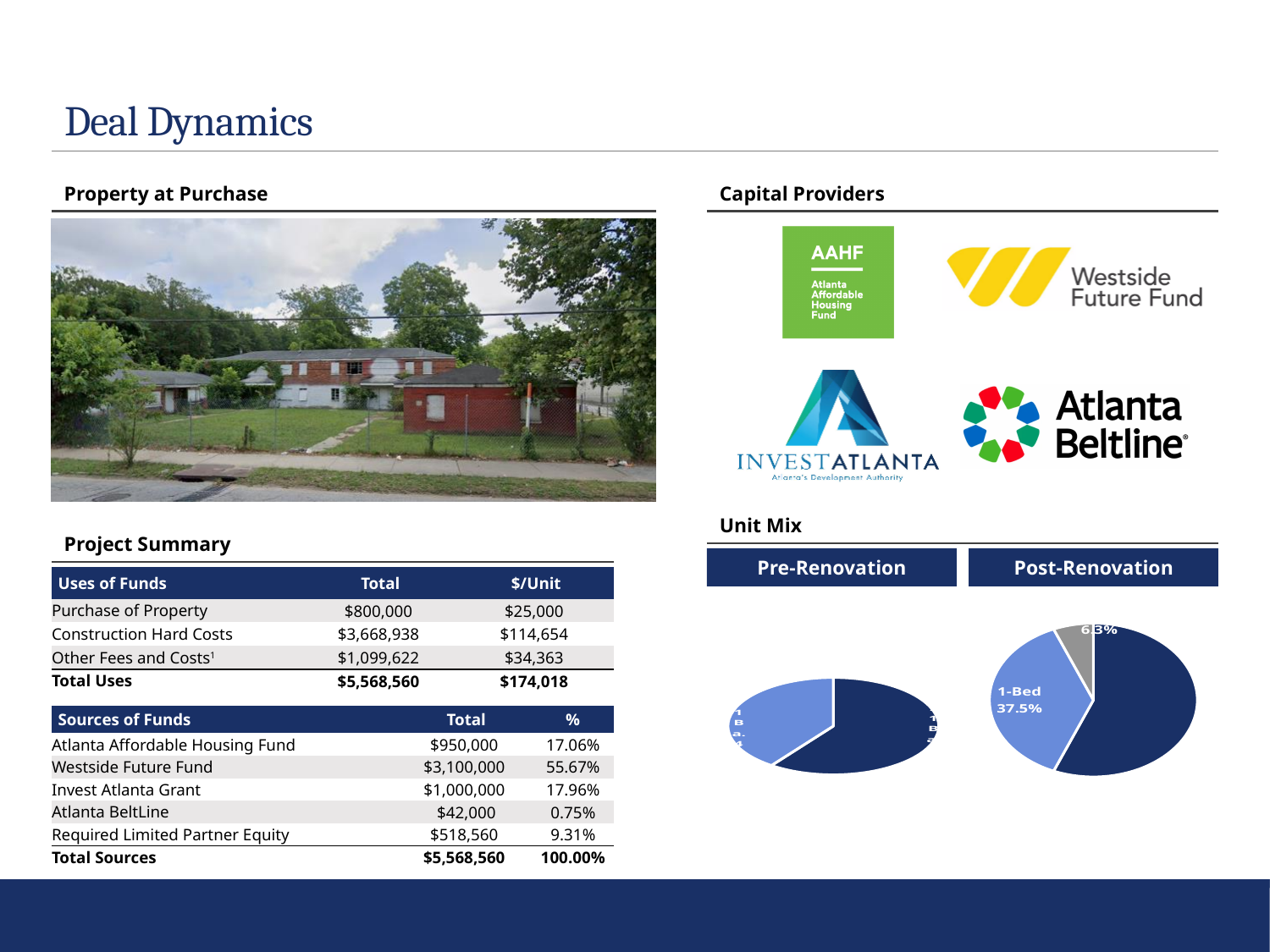
What are the titles of the two pie charts in the Unit Mix section? Pre-Renovation and Post-Renovation How many pie charts are shown in the Unit Mix section? 2 In the Post-Renovation pie chart, what colour is the 1-Bed slice? Light blue In the Pre-Renovation pie chart, does the dark blue slice take up more or less than half of the pie? more What kind of chart is used in the Unit Mix section of the slide? Pie chart In the Post-Renovation pie chart, what share of units is 1-Bed? 37.5% In the Post-Renovation pie chart, how many slices are there? 3 In the Pre-Renovation pie chart, how many slices are there? 2 In the Post-Renovation pie chart, which is larger: the 1-Bed slice or the grey slice? 1-Bed In the Post-Renovation pie chart, is the 1-Bed share greater or less than 50%? less In the Post-Renovation pie chart, is the 1-Bed slice the largest slice? No In the Post-Renovation pie chart, what share is shown for the smallest (grey) slice? 6.3%